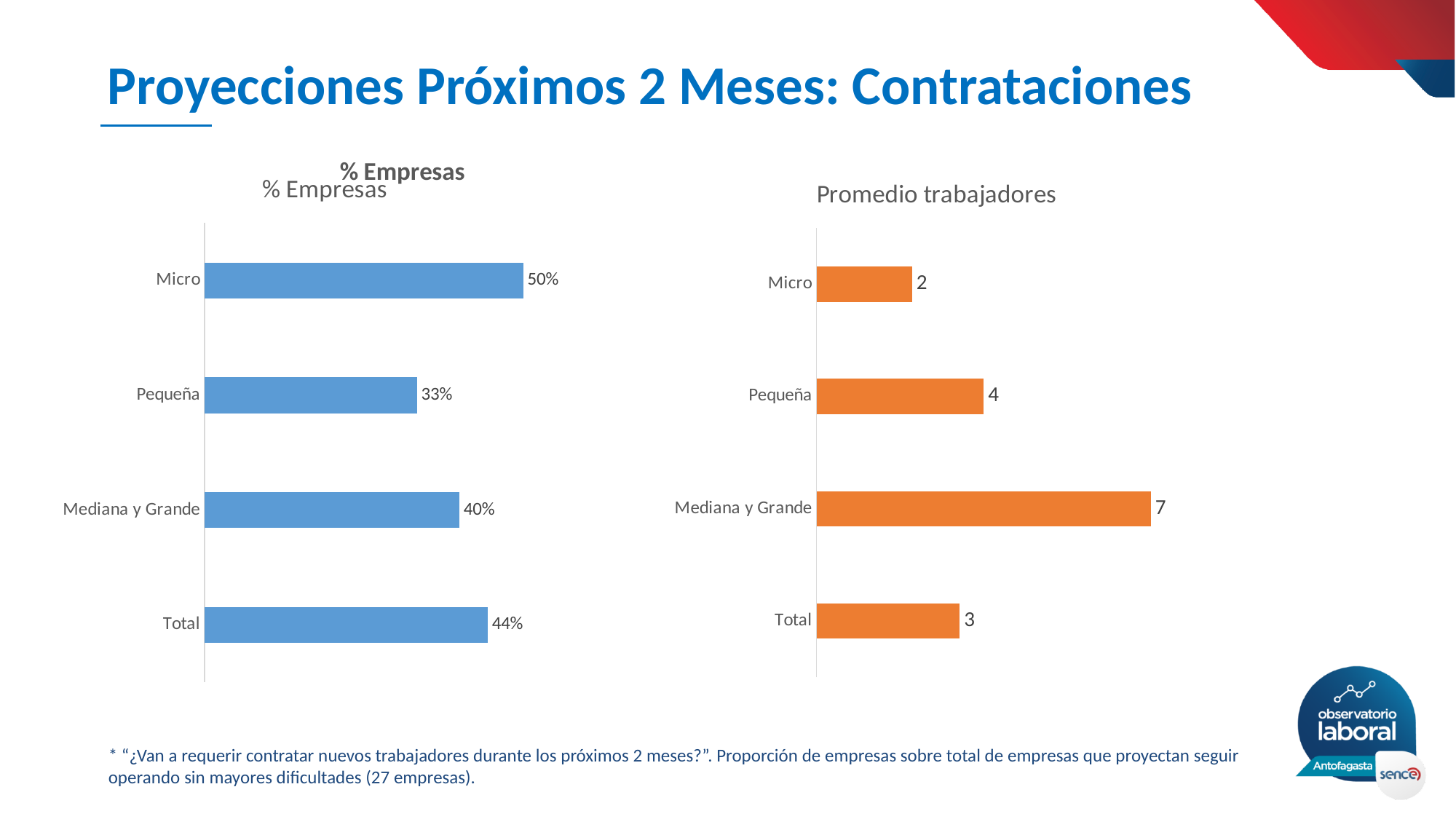
What kind of chart is the '% Empresas' chart? Bar chart In the 'Promedio trabajadores' chart, what is the value for Mediana y Grande? 7 What colour are the bars in the 'Promedio trabajadores' chart? Orange In the '% Empresas' chart, what is the value for Pequeña? 33% In the '% Empresas' chart, what is the difference between the values for Micro and Total? 6% In the '% Empresas' chart, which category has the lowest value? Pequeña In the 'Promedio trabajadores' chart, what is the difference between the values for Mediana y Grande and Micro? 5 In the '% Empresas' chart, what is the value for Micro? 50% In the '% Empresas' chart, which is larger, the value for Mediana y Grande or the value for Pequeña? Mediana y Grande How many categories are shown in the 'Promedio trabajadores' chart? 4 In the 'Promedio trabajadores' chart, which category has the highest value? Mediana y Grande In the 'Promedio trabajadores' chart, what is the value for Total? 3